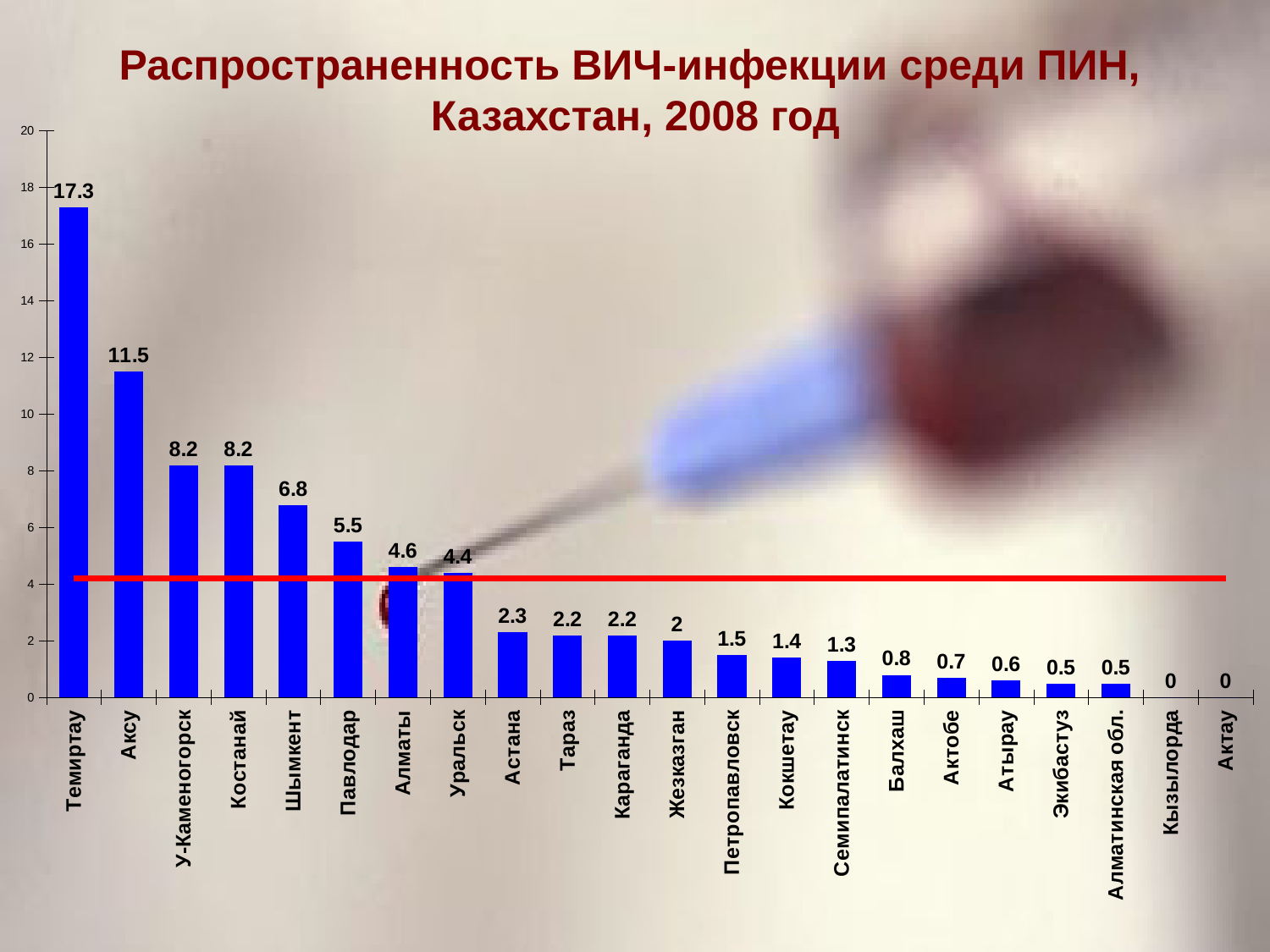
Do the values rise or fall from left to right along the x axis? fall What is the value for Шымкент? 6.8 What is the value for Петропавловск? 1.5 What is the value for Темиртау? 17.3 Which category has the highest value? Темиртау Which is larger, the value for Павлодар or the value for Алматы? Павлодар Is the value for Аксу greater or less than 10? greater What is the value for Кызылорда? 0 What is the difference between the values for Темиртау and Аксу? 5.8 How many categories are shown on the x axis? 22 What is the title of the chart? Распространенность ВИЧ-инфекции среди ПИН, Казахстан, 2008 год What kind of chart is shown on the slide? bar chart